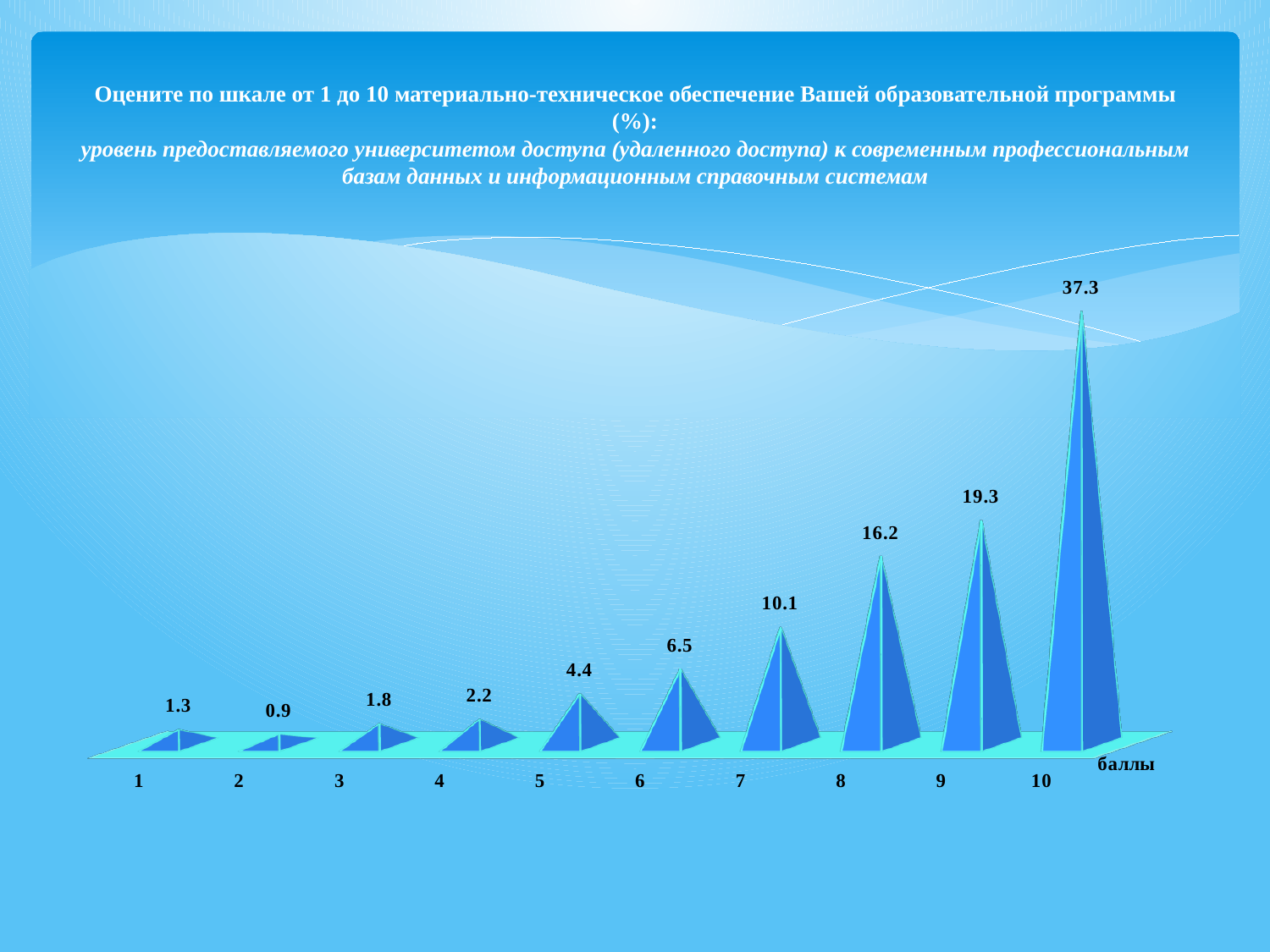
What is the difference between the values for score 8 and score 7? 6.1 What value is shown for score 2? 0.9 Do the values generally rise or fall from score 3 to score 10? rise How many score categories are shown on the x axis? 10 What kind of chart is shown on the slide? bar chart What value is shown for score 7? 10.1 Which score has the highest value? 10 What is the label of the x axis? баллы Which is larger, the value for score 5 or the value for score 6? score 6 What value is shown for score 10? 37.3 What is the difference between the values for score 10 and score 9? 18 Which score has the lowest value? 2